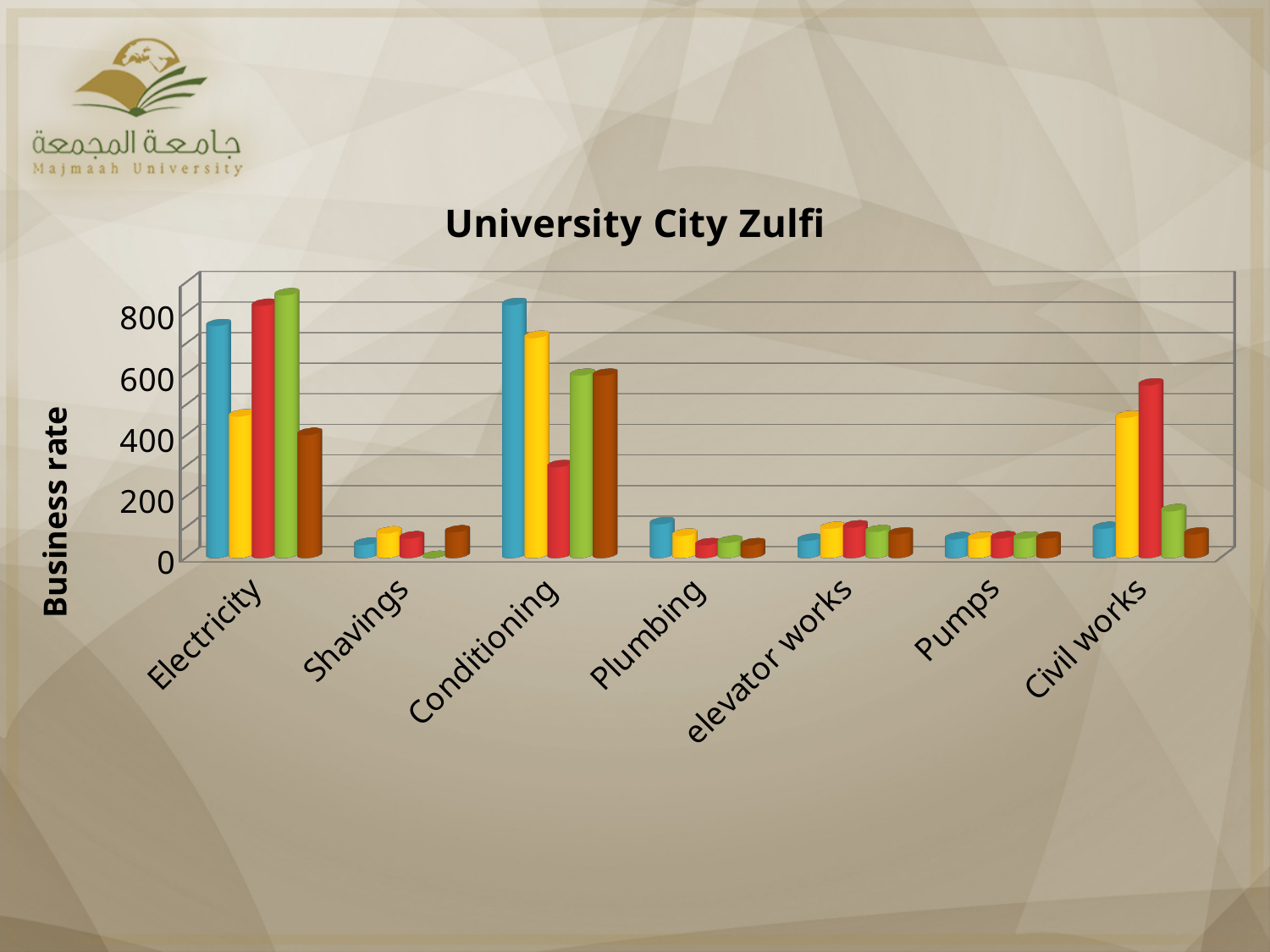
Is the value of the red bar for Conditioning greater or less than 400? less Which is larger: the blue bar for Electricity or the blue bar for Shavings? Electricity How many categories are shown along the x axis of the chart? 7 What is the label on the vertical axis of the chart? Business rate What is the title of the chart? University City Zulfi How many bars are plotted for each category in the chart? 5 Which is larger for Conditioning: the blue bar or the red bar? the blue bar Is the value of the red bar for Civil works greater or less than 400? greater What kind of chart is shown on the slide? bar chart Are all the bars for Pumps greater or less than 200? less Which category has the tallest green bar? Electricity